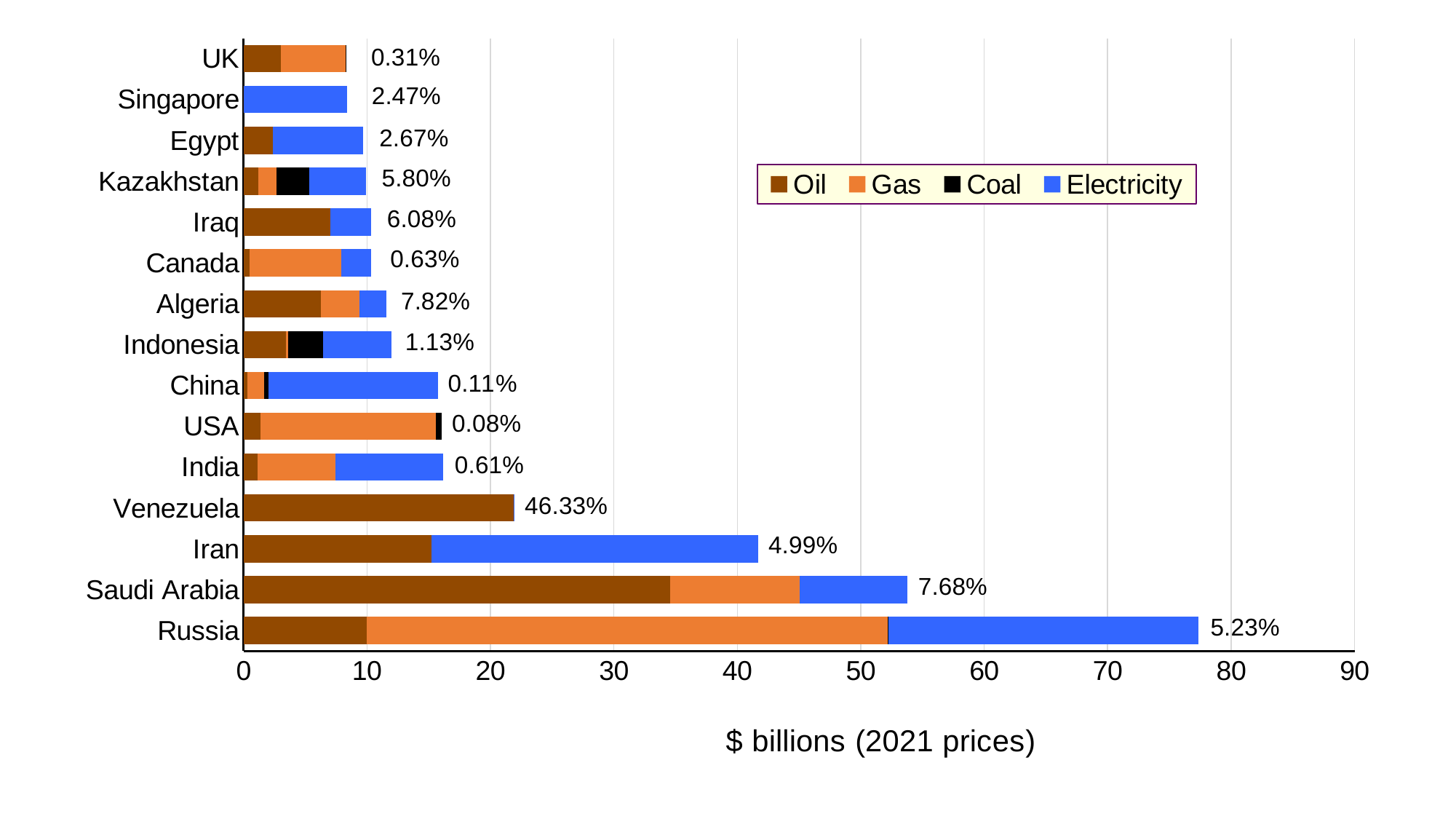
How many countries are shown on the chart? 15 How many series does the legend list? 4 Which country has the highest percentage label on the chart? Venezuela Which has the longer bar, Saudi Arabia or Iran? Saudi Arabia Is the total bar length for Iran greater or less than 50? less Is the total bar length for Russia greater or less than 70? greater What kind of chart is shown on the slide? bar chart What is the title of the x axis? $ billions (2021 prices) Which country has the longest bar on the chart? Russia What percentage label is shown next to the bar for USA? 0.08% What percentage label is shown next to the bar for Russia? 5.23% What percentage label is shown next to the bar for Venezuela? 46.33%